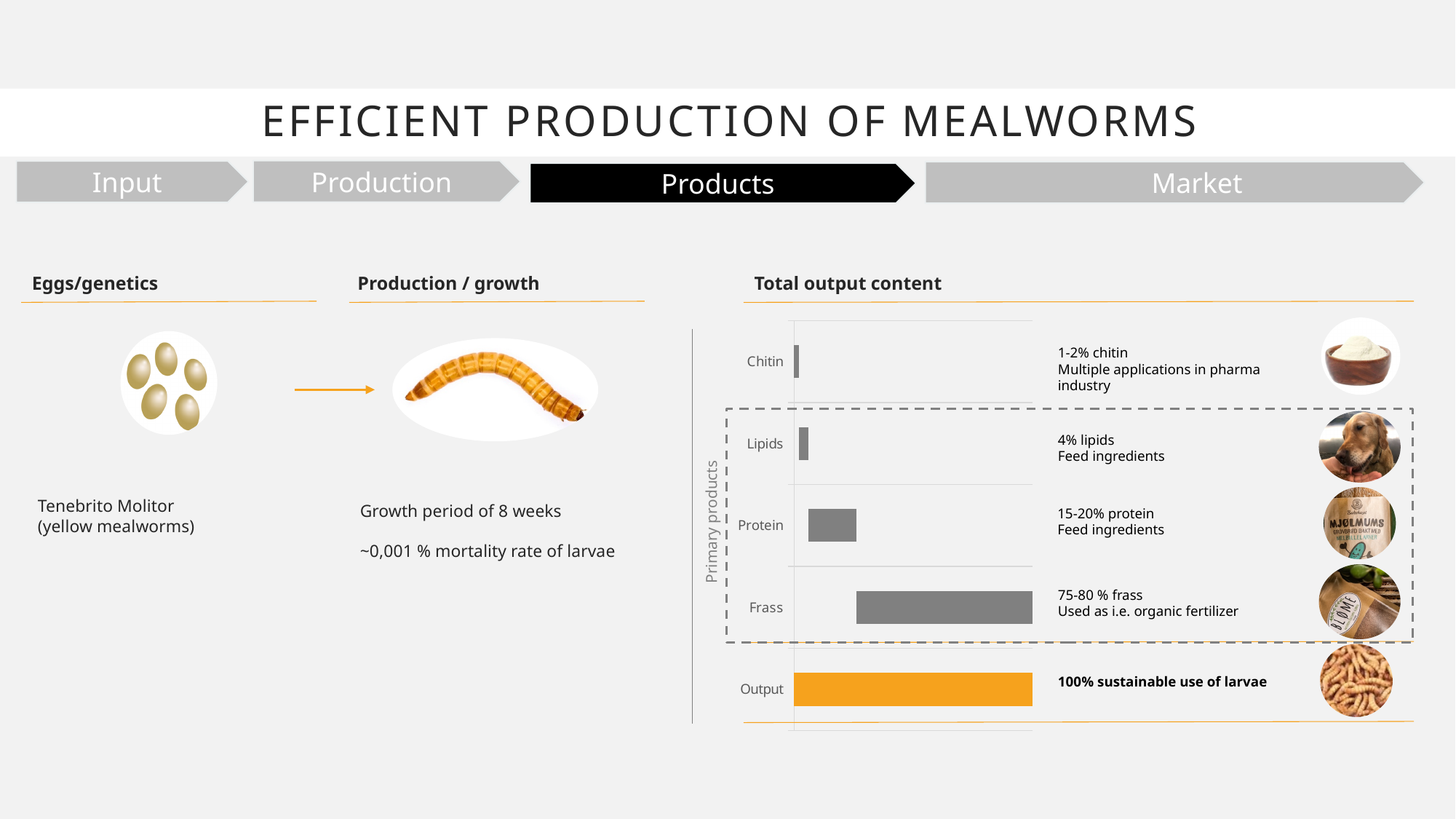
What type of chart is shown under "Total output content"? bar chart What percentage range is given for protein in the "Total output content" chart? 15-20% Which bar in the "Total output content" chart is coloured orange? Output In the "Total output content" chart, which bar is larger: Protein or Lipids? Protein What percentage range is given for frass in the "Total output content" chart? 75-80 % Among the primary products (Chitin, Lipids, Protein, Frass), which has the smallest bar? Chitin What is the title of the chart on the right side of the slide? Total output content What percentage is given for lipids in the "Total output content" chart? 4% What percentage range is given for chitin in the "Total output content" chart? 1-2% Among the primary products (Chitin, Lipids, Protein, Frass), which has the largest bar? Frass What percentage is shown for the Output bar in the "Total output content" chart? 100% How many bars does the "Total output content" chart show? 5